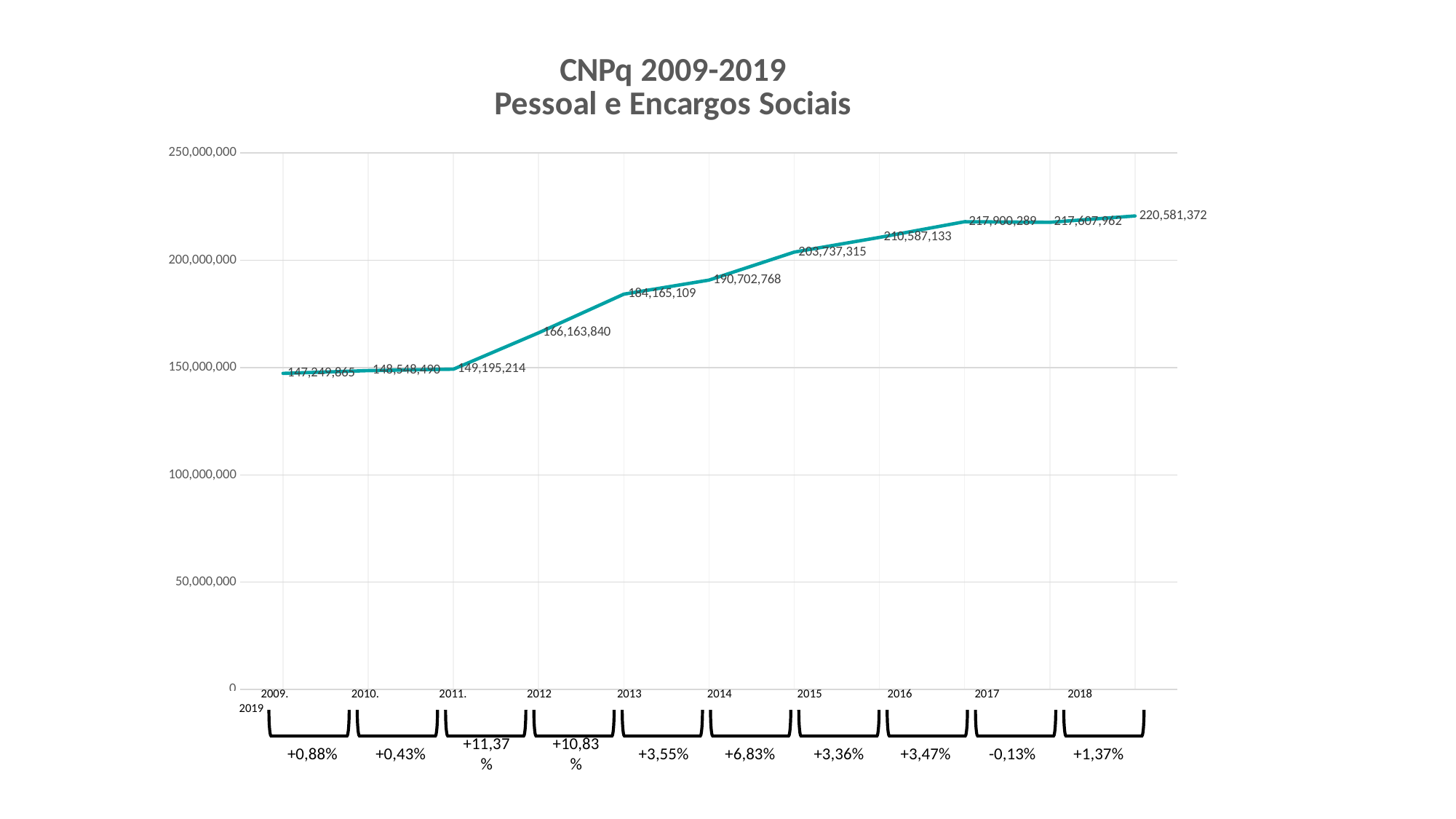
Which year has the lowest value? 2009 How many years (data points) are plotted on the chart? 11 What kind of chart is shown on the slide? Line chart What is the value for 2019? 220,581,372 Which year has the highest value? 2019 What is the title of the chart? CNPq 2009-2019 Pessoal e Encargos Sociais What is the value for 2012? 166,163,840 Is the value for 2012 greater or less than 150,000,000? greater What is the difference between the values for 2013 and 2012? 18,001,269 What is the value for 2015? 203,737,315 Which is larger, the value for 2014 or the value for 2016? 2016 Do the values generally rise or fall from 2009 to 2019? Rise